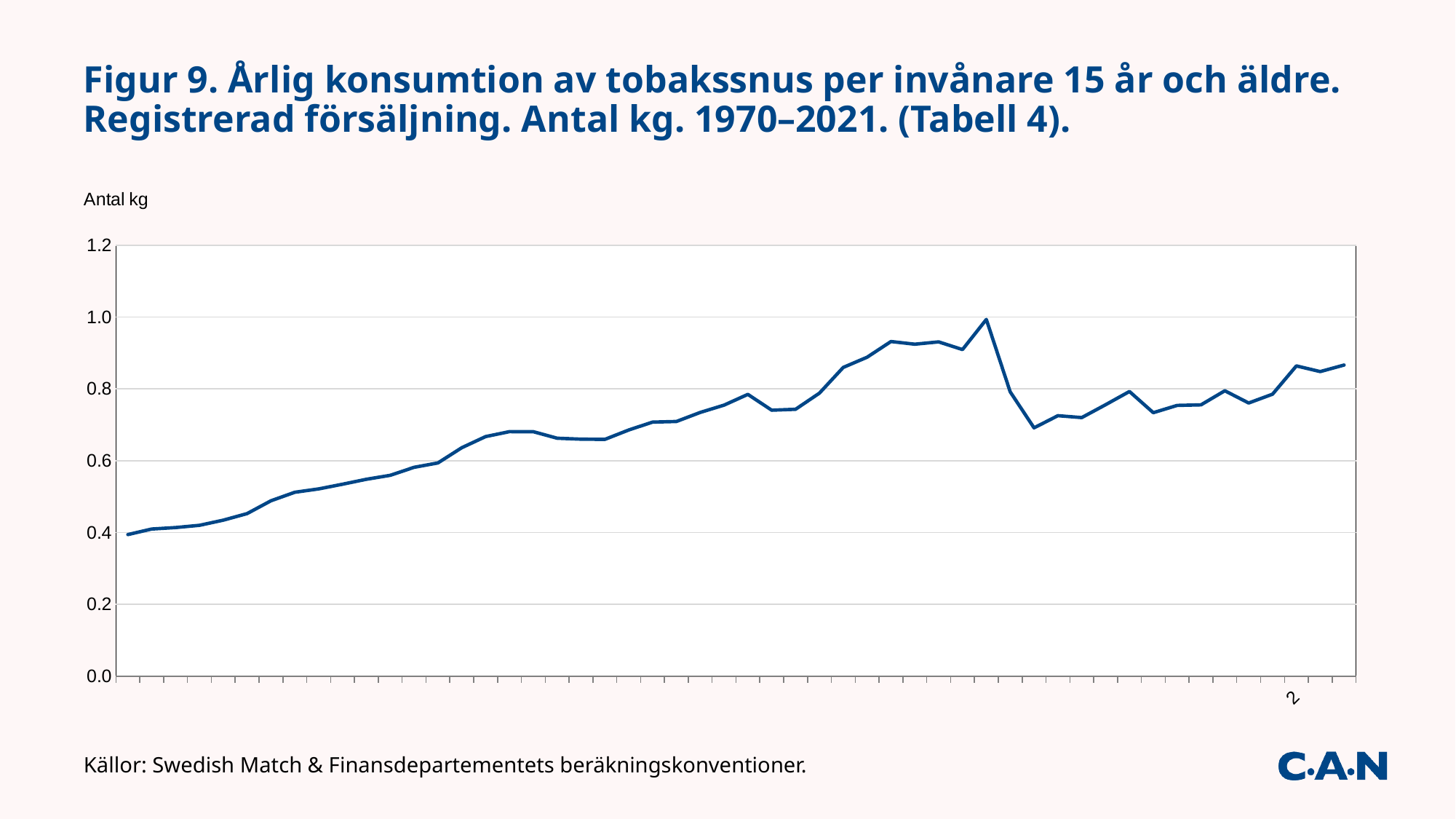
Is the value at the first point of the line (1970) greater or less than 0.6? less Is the highest value reached by the line greater or less than 1.2? less Is the value at the last point of the line (2021) greater or less than 0.8? greater How many lines are plotted on the chart? 1 What is the label on the vertical axis of the chart? Antal kg Overall, does the plotted value rise or fall from the start of the series (1970) to the end (2021)? rise What kind of chart is shown on the slide? line chart Which is larger, the value at the first point of the line (1970) or the value at the last point (2021)? the last point (2021) What is the highest tick value shown on the vertical axis? 1.2